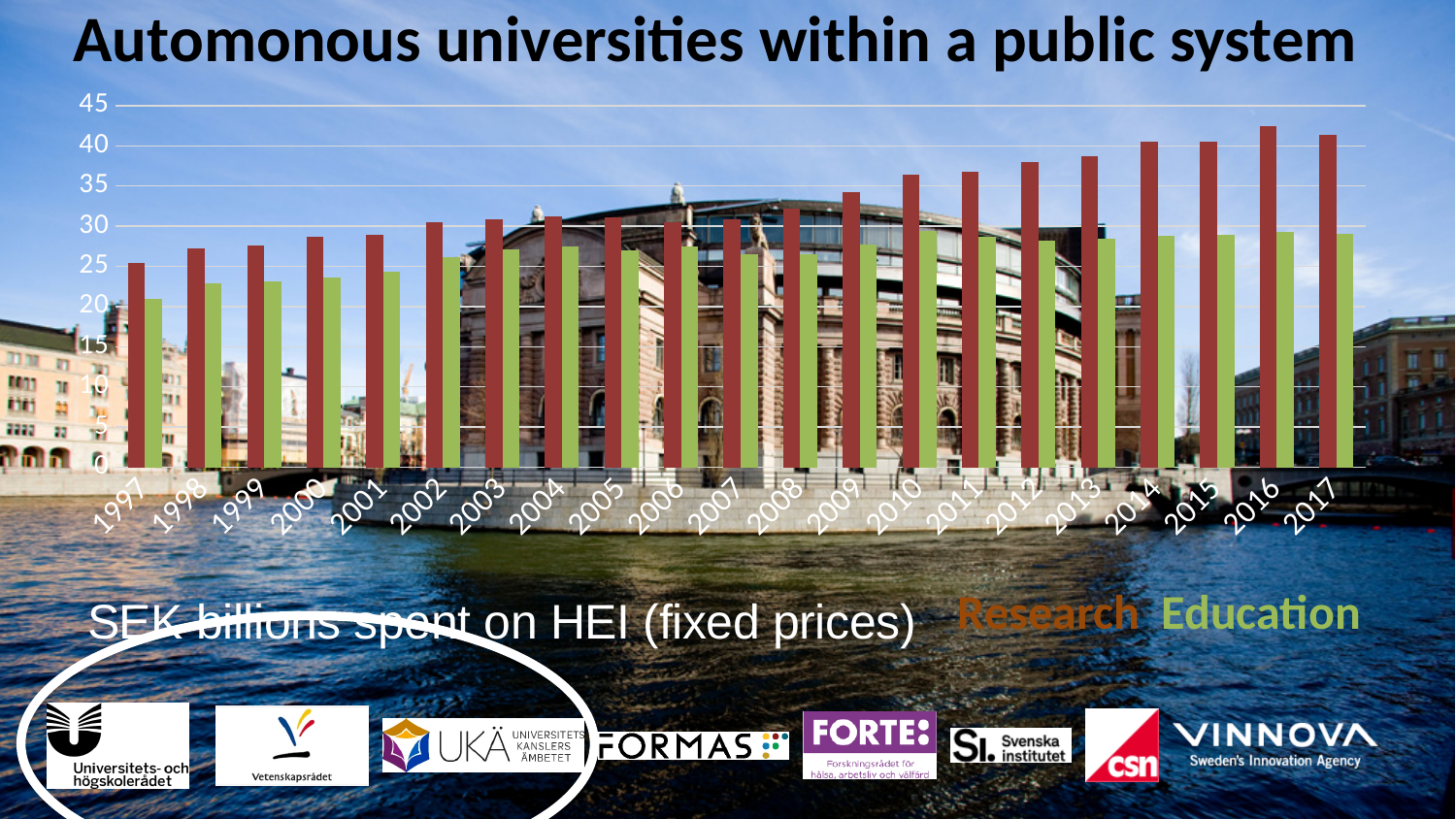
Which year has the lowest Education value? 1997 How many years are shown along the x axis? 21 Which year has the lowest Research value? 1997 Is the Research value for 1997 greater or less than 30? less How many series does the legend list? 2 Do the Research values generally rise or fall from 1997 to 2017? Rise What kind of chart is shown on the slide? Bar chart Is the Education value for 1997 greater or less than 25? less In 2017, which is larger, Research or Education? Research Which year has the highest Research value? 2016 Which colour represents the Education series? Green Is the Research value for 2016 greater or less than 40? greater